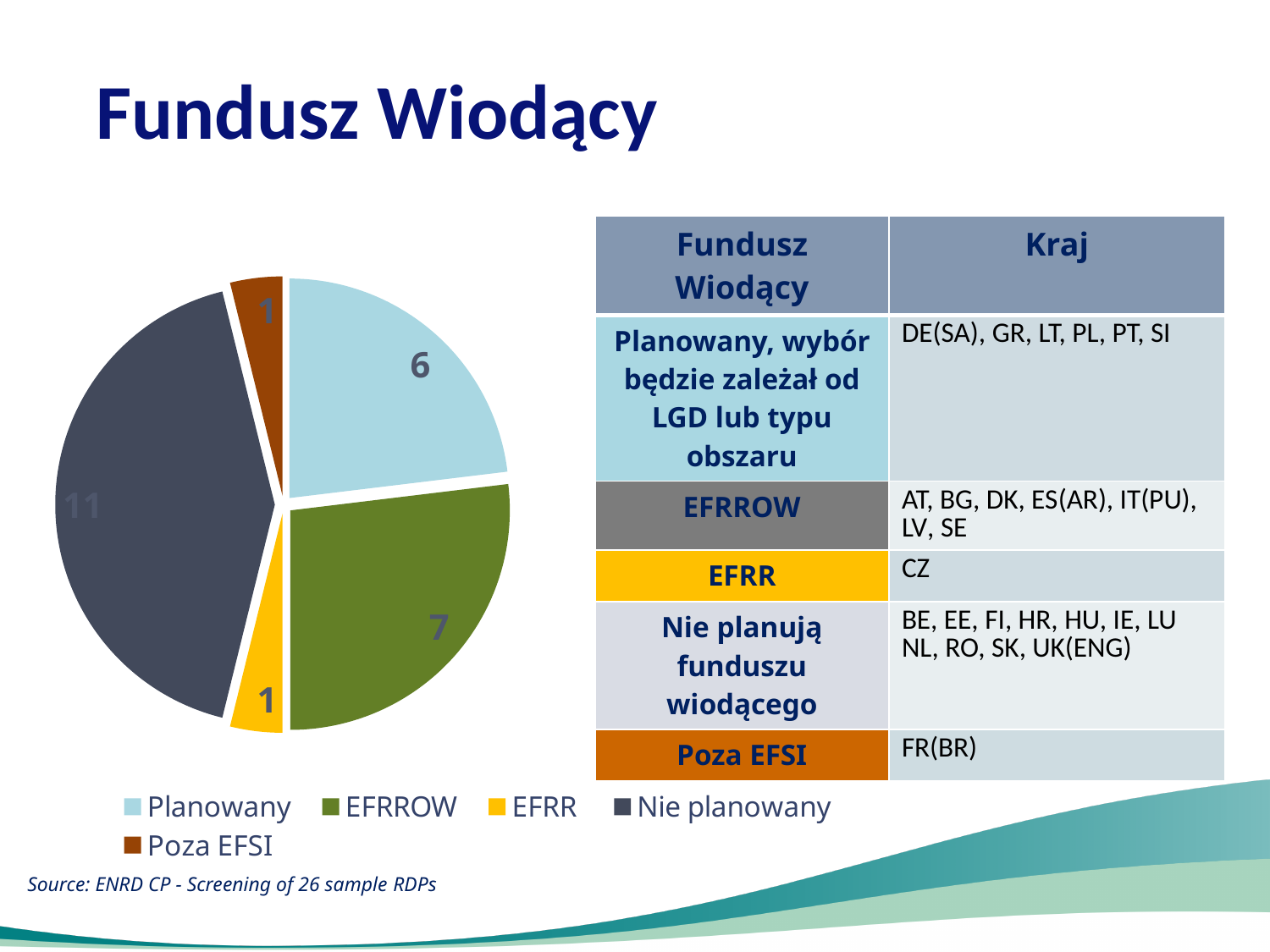
Which category has the largest slice in the pie chart? Nie planowany What is the total of all slices in the pie chart? 26 What kind of chart is shown on the slide? pie chart What is the value for the EFRR slice of the pie chart? 1 Which colour represents Poza EFSI in the pie chart? brown How many categories does the legend of the pie chart list? 5 Which category is larger in the pie chart, Planowany or EFRROW? EFRROW What share of the pie does the EFRROW slice represent? 7/26 What is the value for the EFRROW slice of the pie chart? 7 What is the value for the Planowany slice of the pie chart? 6 What is the difference between the Nie planowany and EFRROW values in the pie chart? 4 What is the value for the Nie planowany slice of the pie chart? 11